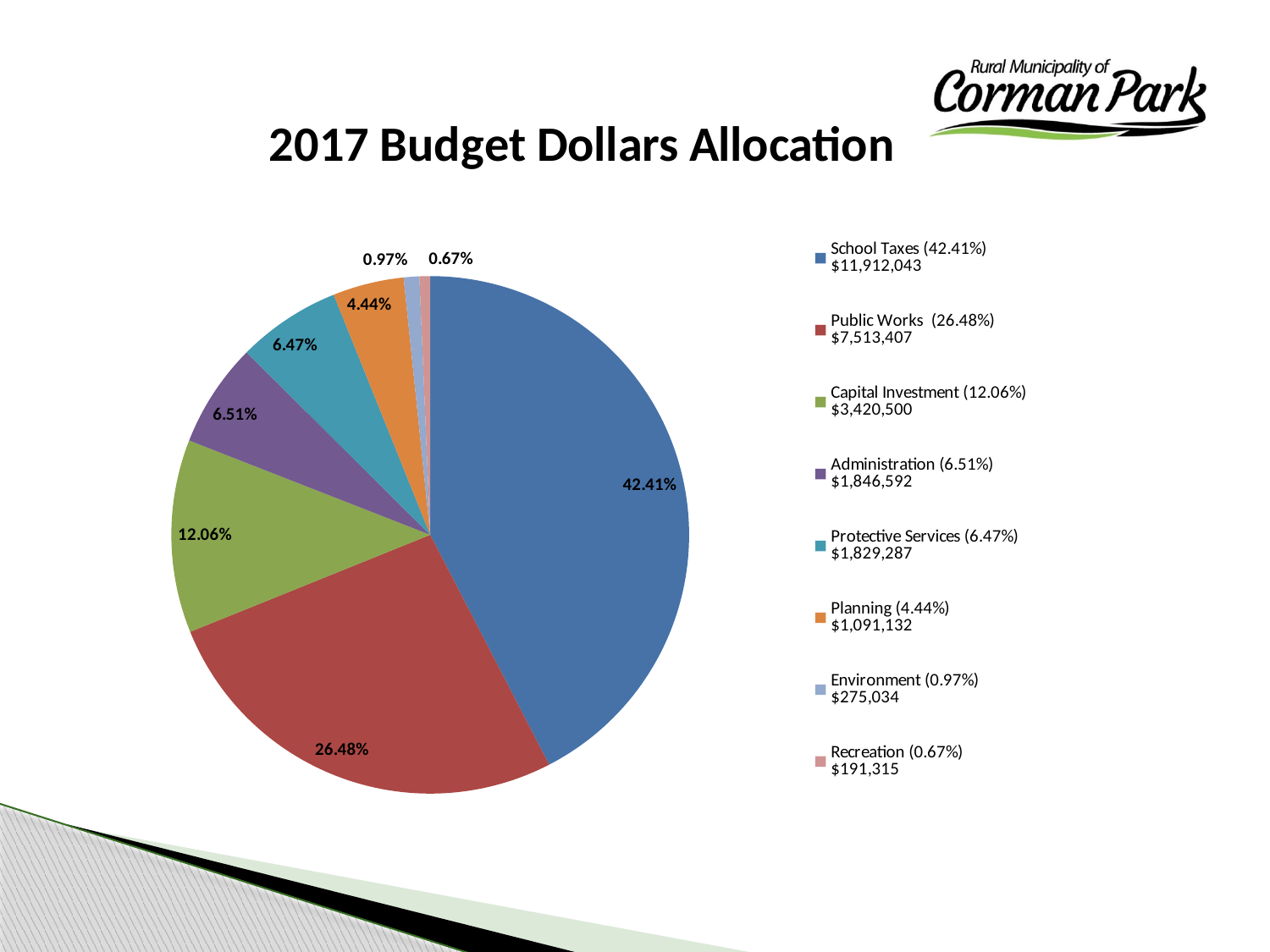
What is the title of the chart? 2017 Budget Dollars Allocation What dollar amount is listed for Capital Investment? $3,420,500 What kind of chart is shown on the slide? pie chart What is the difference in percentage points between School Taxes and Public Works? 15.93 Which is larger, the share for Administration or the share for Planning? Administration What dollar amount is listed for Public Works in the legend? $7,513,407 How many categories does the pie chart have? 8 Which category has the largest slice of the pie? School Taxes What percentage share is shown for Environment? 0.97% What share of the pie does School Taxes represent? 42.41% What colour is the slice for Protective Services? teal Which category has the smallest slice of the pie? Recreation